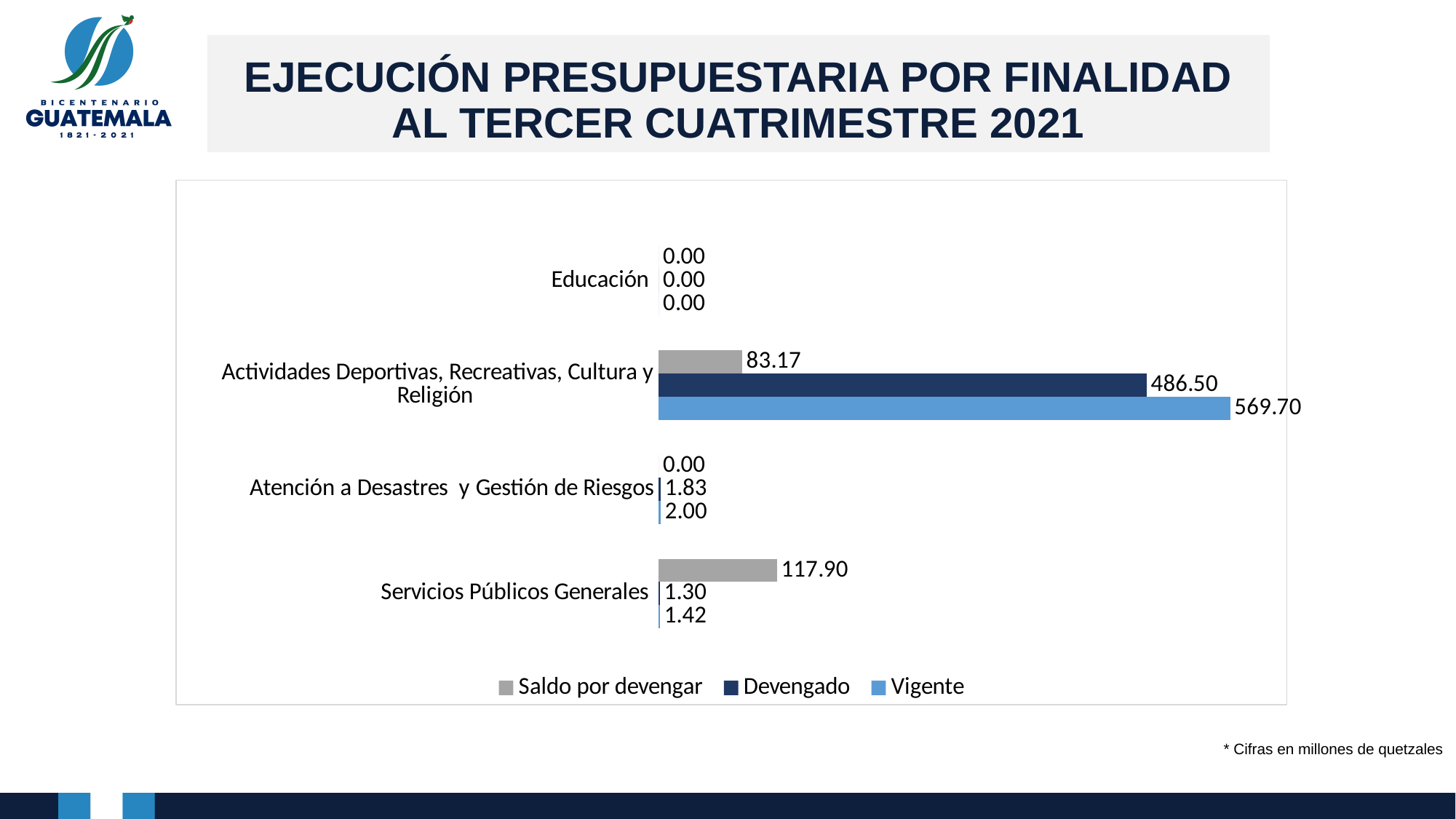
How many categories are shown on the chart? 4 What is the Vigente value for Servicios Públicos Generales? 1.42 Which is larger for Servicios Públicos Generales: Saldo por devengar or Devengado? Saldo por devengar What is the Saldo por devengar value for Servicios Públicos Generales? 117.90 What is the Devengado value for Atención a Desastres y Gestión de Riesgos? 1.83 What kind of chart is shown on the slide? Bar chart How many series does the legend list? 3 Which category has the highest Vigente value? Actividades Deportivas, Recreativas, Cultura y Religión What is the difference between the Vigente and Devengado values for Actividades Deportivas, Recreativas, Cultura y Religión? 83.20 What is the Devengado value for Actividades Deportivas, Recreativas, Cultura y Religión? 486.50 What is the Vigente value for Actividades Deportivas, Recreativas, Cultura y Religión? 569.70 Which series is shown in grey in the legend? Saldo por devengar